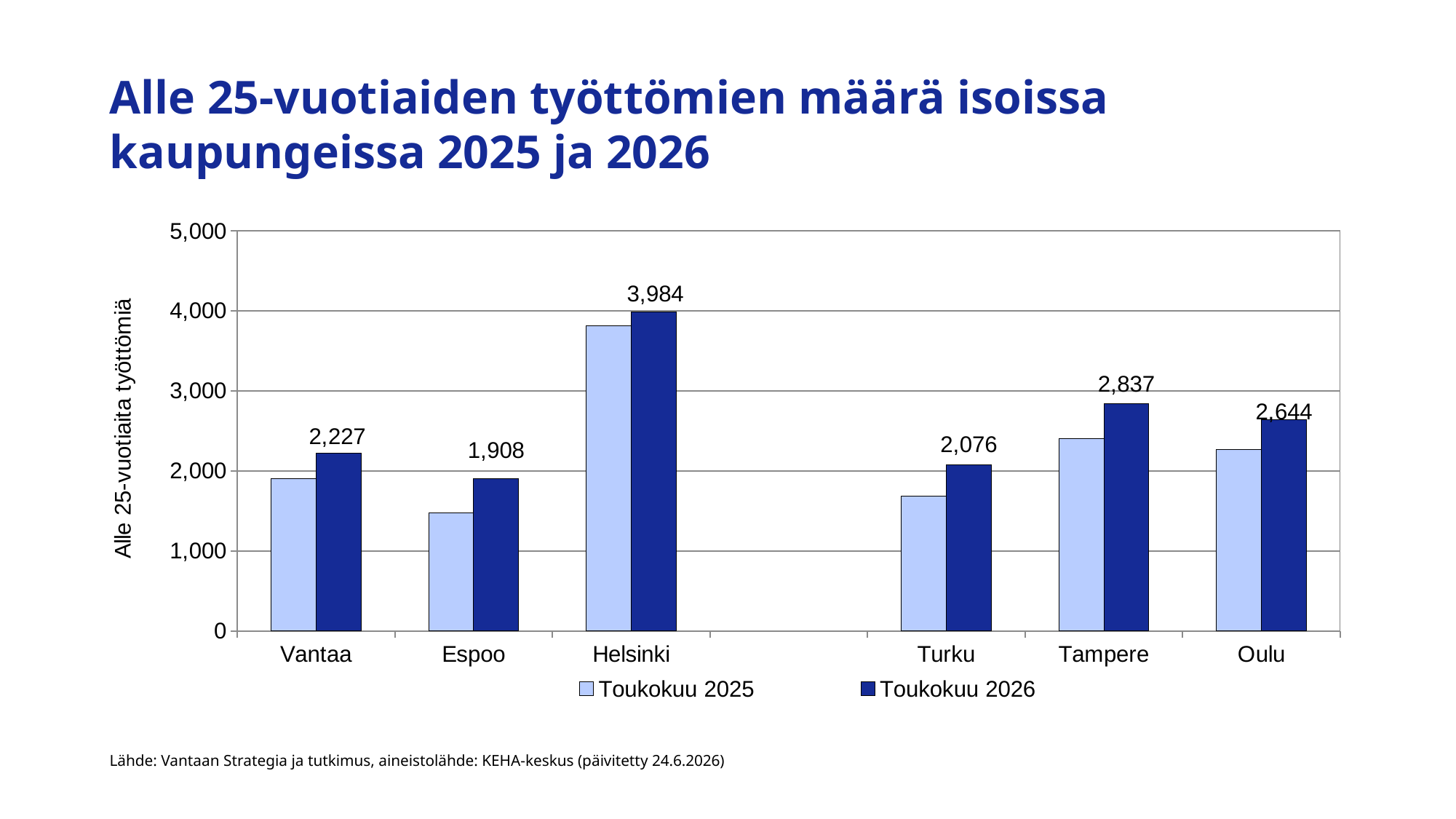
In the Toukokuu 2026 series, which is larger: Vantaa or Turku? Vantaa What is the value for Tampere in the Toukokuu 2026 series? 2,837 Which city has the lowest value in the Toukokuu 2026 series? Espoo How many series does the legend list? 2 What is the difference between the Toukokuu 2026 values for Helsinki and Vantaa? 1,757 What is the value for Helsinki in the Toukokuu 2026 series? 3,984 Which city has the highest value in the Toukokuu 2026 series? Helsinki What is the difference between the Toukokuu 2026 values for Tampere and Oulu? 193 What is the value for Espoo in the Toukokuu 2026 series? 1,908 Is the Toukokuu 2025 value for Espoo greater or less than 2,000? less Is the Toukokuu 2025 value for Helsinki greater or less than 3,000? greater How many cities are shown on the x axis of the chart? 6